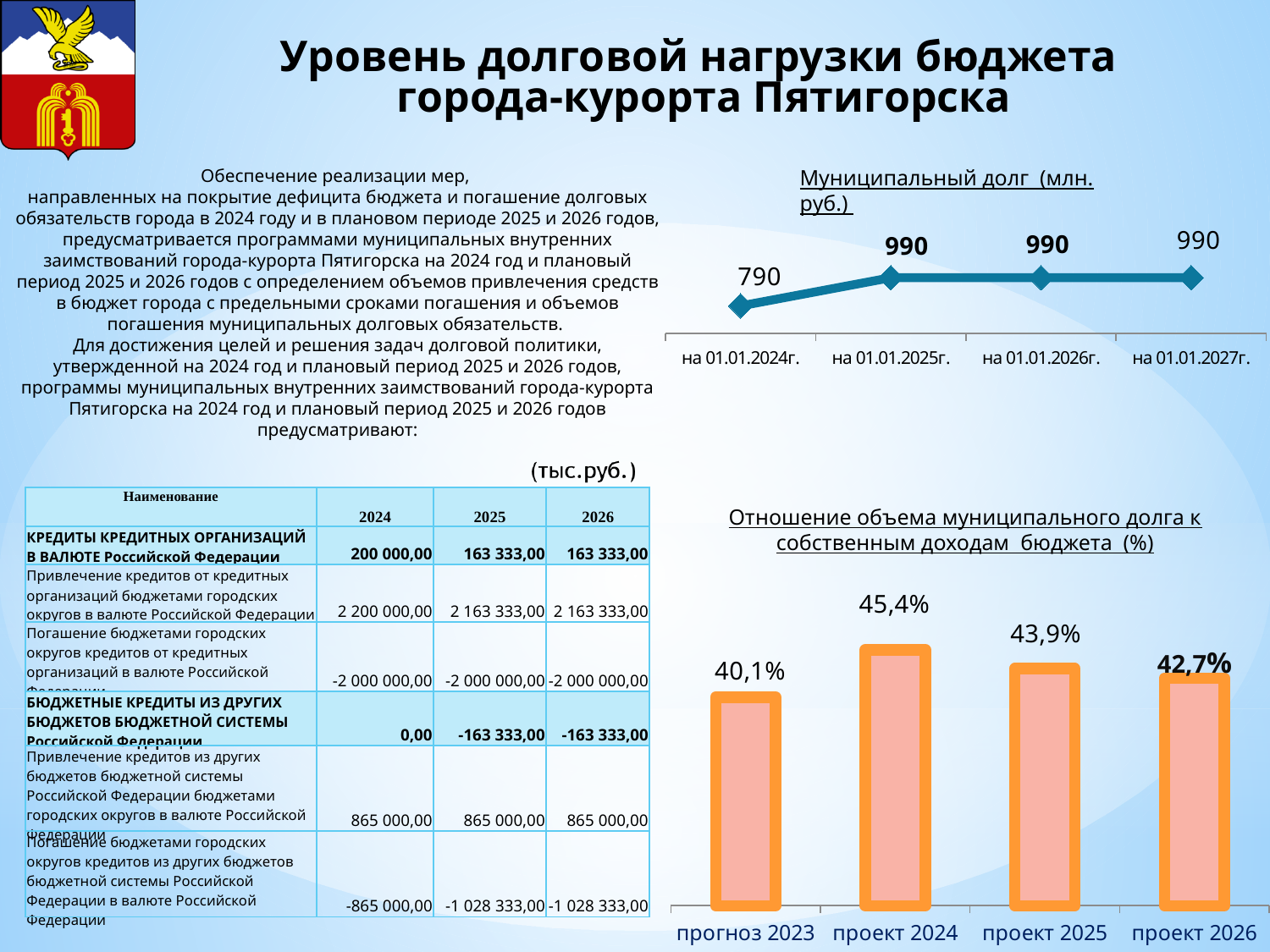
On the chart 'Отношение объема муниципального долга к собственным доходам бюджета (%)', which category has the lowest value? прогноз 2023 What type of chart is 'Муниципальный долг (млн. руб.)'? Line chart On the chart 'Отношение объема муниципального долга к собственным доходам бюджета (%)', what is the value for 'проект 2026'? 42,7% On the chart 'Муниципальный долг (млн. руб.)', which date has the lowest value? на 01.01.2024г. On the chart 'Муниципальный долг (млн. руб.)', what is the value for 'на 01.01.2024г.'? 790 On the chart 'Отношение объема муниципального долга к собственным доходам бюджета (%)', what is the value for 'проект 2024'? 45,4% On the chart 'Отношение объема муниципального долга к собственным доходам бюджета (%)', which category has the highest value? проект 2024 On the chart 'Муниципальный долг (млн. руб.)', what is the difference between the values for 'на 01.01.2025г.' and 'на 01.01.2024г.'? 200 On the chart 'Муниципальный долг (млн. руб.)', what is the value for 'на 01.01.2026г.'? 990 What type of chart is 'Отношение объема муниципального долга к собственным доходам бюджета (%)'? Bar chart On the chart 'Муниципальный долг (млн. руб.)', how many data points are plotted? 4 On the chart 'Отношение объема муниципального долга к собственным доходам бюджета (%)', which is larger: 'проект 2025' or 'проект 2026'? проект 2025